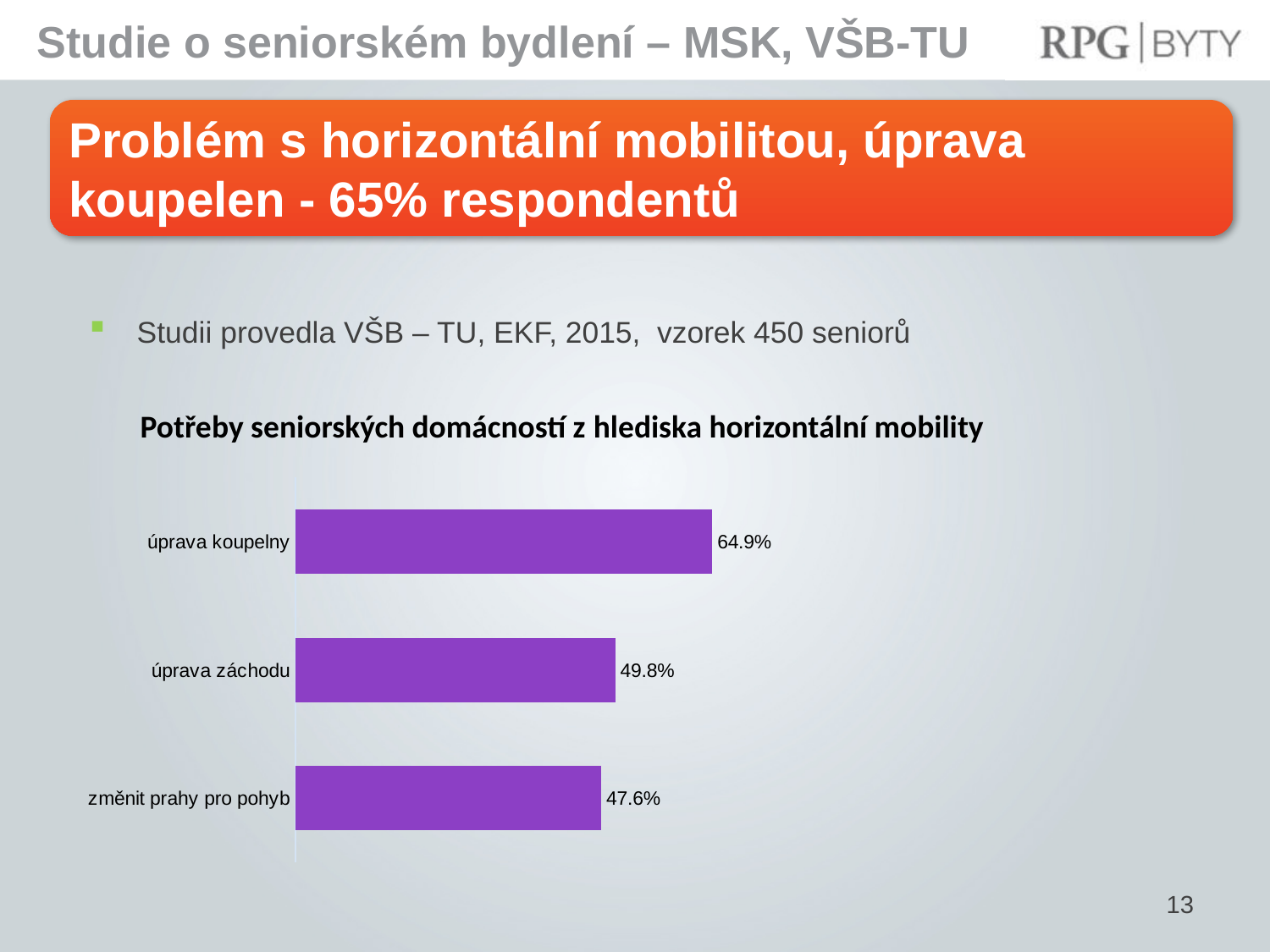
What is the value for úprava koupelny? 64.9% What is the value for úprava záchodu? 49.8% What colour are the bars in the chart? purple What is the difference between the values for úprava koupelny and úprava záchodu? 15.1% What kind of chart is shown on the slide? bar chart Which category has the highest value? úprava koupelny What is the title of the chart? Potřeby seniorských domácností z hlediska horizontální mobility What is the value for změnit prahy pro pohyb? 47.6% How many categories are shown in the chart? 3 What is the difference between the values for úprava záchodu and změnit prahy pro pohyb? 2.2% Which is larger, the value for úprava koupelny or the value for změnit prahy pro pohyb? úprava koupelny Which category has the lowest value? změnit prahy pro pohyb